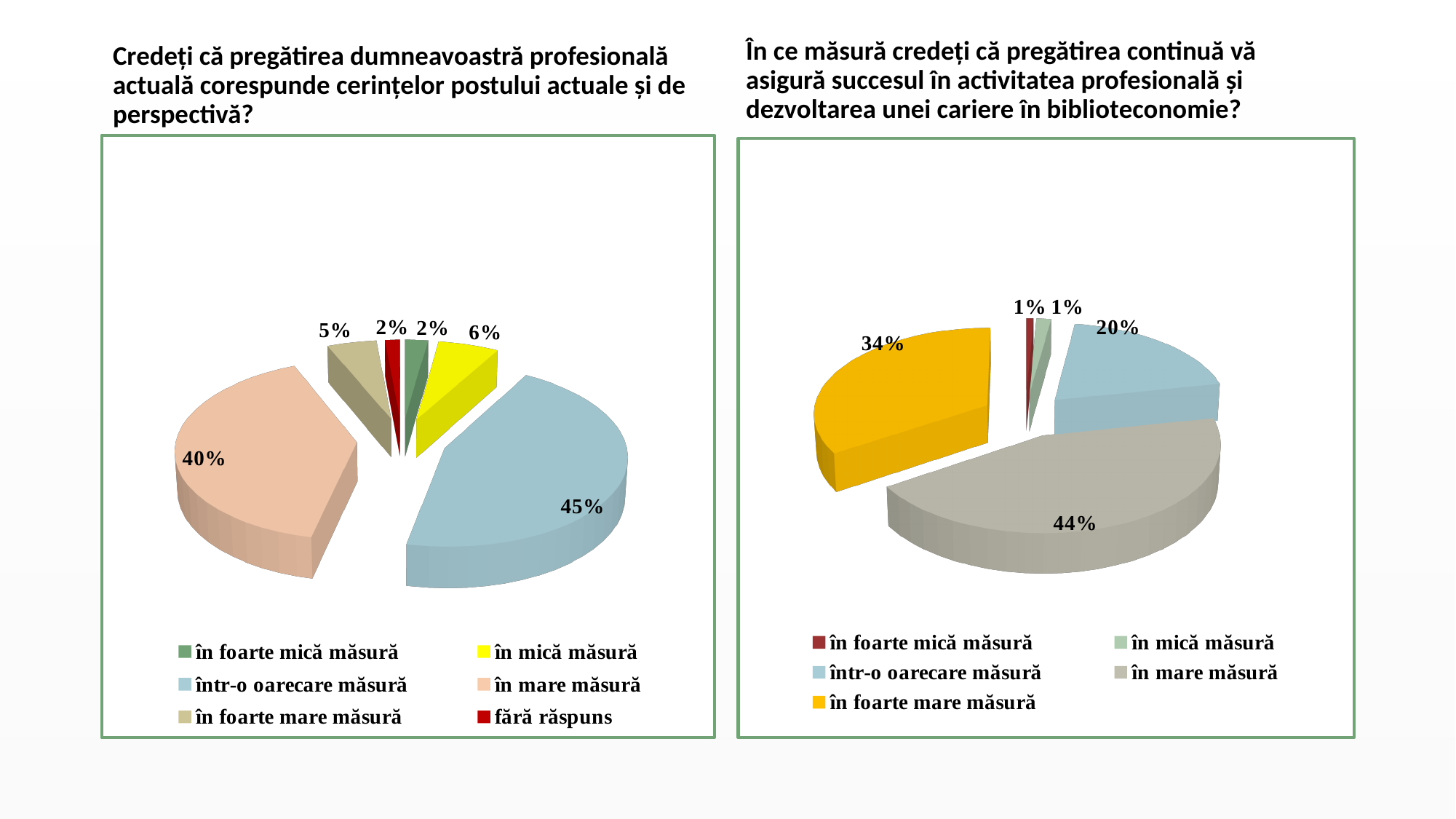
In the left pie chart, which category has the largest share? într-o oarecare măsură In the right pie chart, what percentage is shown for "în foarte mare măsură"? 34% In the right pie chart, which is larger: "în foarte mare măsură" or "într-o oarecare măsură"? în foarte mare măsură In the right pie chart, which category has the largest share? în mare măsură In the left pie chart, what is the difference between the shares for "într-o oarecare măsură" and "în mare măsură"? 5% In the left pie chart, what percentage is shown for "în mare măsură"? 40% In the left pie chart, what percentage is shown for "în mică măsură"? 6% In the right pie chart, what percentage is shown for "într-o oarecare măsură"? 20% In the left pie chart, what percentage is shown for "într-o oarecare măsură"? 45% How many categories does the legend of the left pie chart list? 6 What type of chart is shown on the right side of the slide? Pie chart In the right pie chart, what percentage is shown for "în mare măsură"? 44%